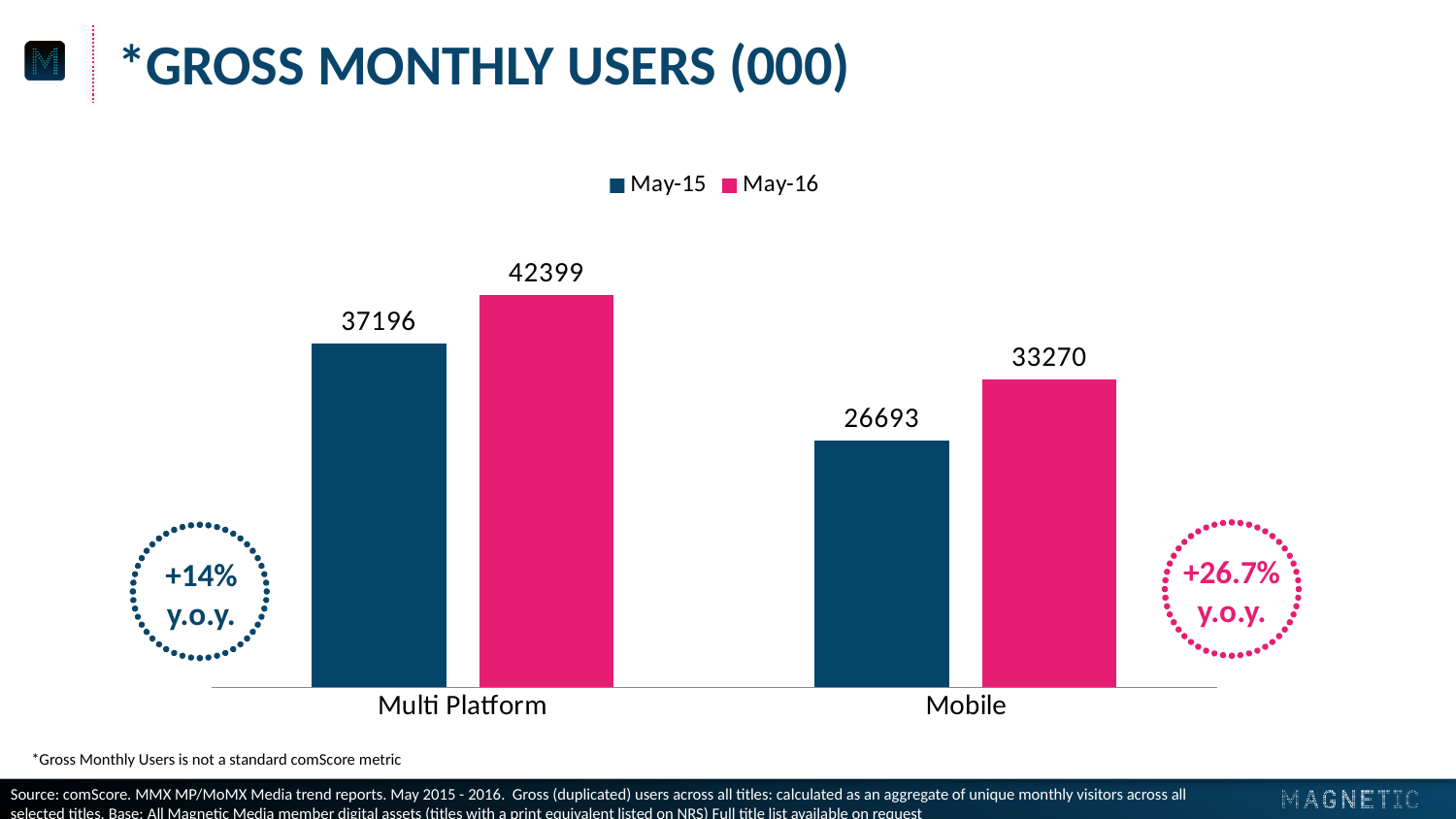
What is the May-15 value for Multi Platform? 37196 What is the May-16 value for Mobile? 33270 What is the difference between the May-16 and May-15 values for Mobile? 6577 What is the May-15 value for Mobile? 26693 What kind of chart is shown on the slide? Bar chart Which is larger: the May-15 value for Multi Platform or the May-16 value for Mobile? May-15 value for Multi Platform Which category has the highest May-16 value? Multi Platform How many categories are shown on the x axis? 2 What is the May-16 value for Multi Platform? 42399 What is the difference between the May-16 and May-15 values for Multi Platform? 5203 How many series does the legend list? 2 Which category has the lowest May-15 value? Mobile